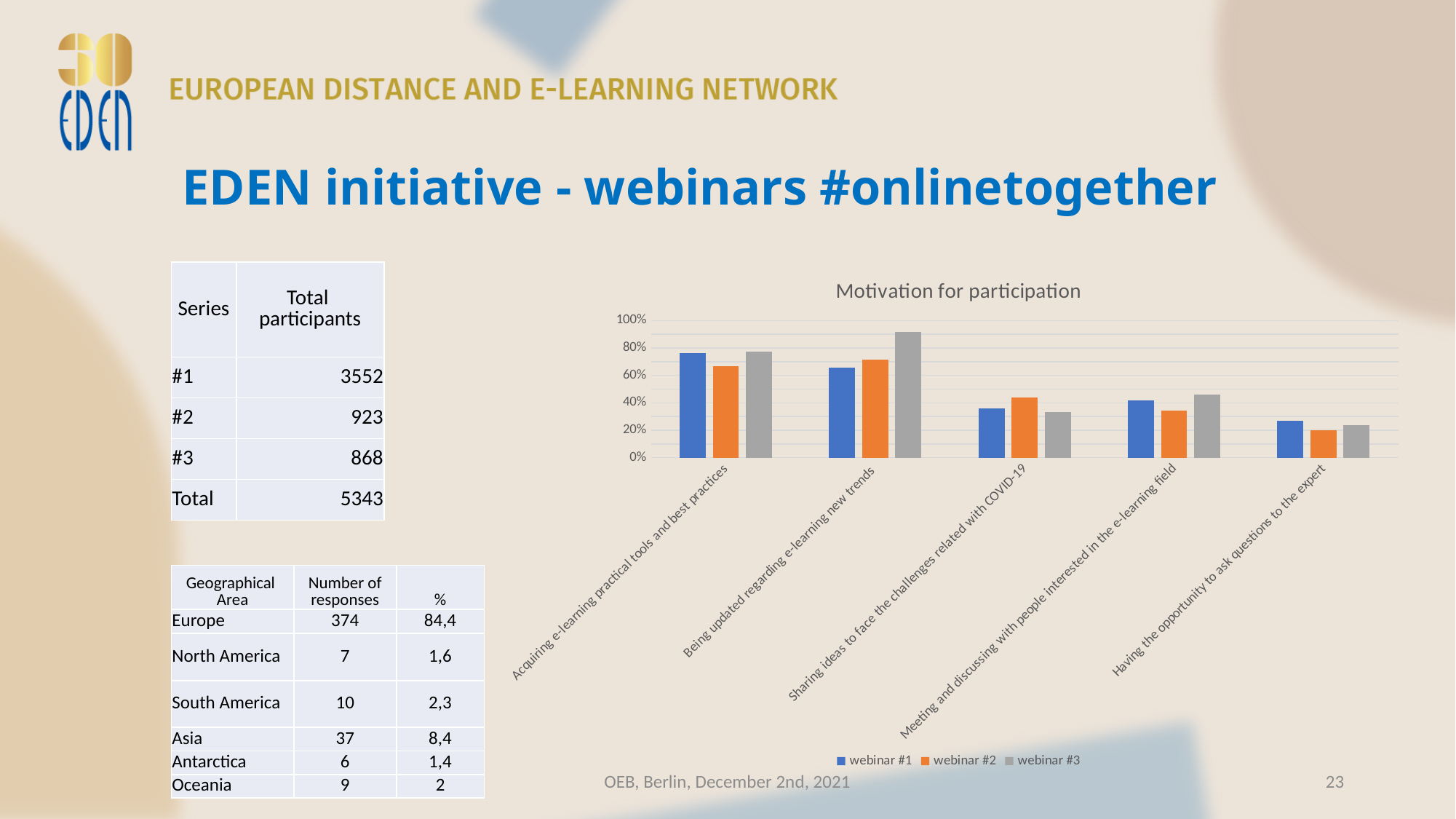
For 'Being updated regarding e-learning new trends', which is larger: webinar #1 or webinar #3? webinar #3 What is the title of the chart? Motivation for participation Which category has the tallest bar in the chart? Being updated regarding e-learning new trends Is the webinar #2 value for 'Having the opportunity to ask questions to the expert' greater or less than 40%? less Which category has the lowest values across all three webinars? Having the opportunity to ask questions to the expert Is the webinar #3 value for 'Being updated regarding e-learning new trends' greater or less than 80%? greater Which series is shown in orange in the chart? webinar #2 How many motivation categories are shown on the x axis of the chart? 5 For 'Sharing ideas to face the challenges related with COVID-19', which is larger: webinar #2 or webinar #3? webinar #2 Is the webinar #1 value for 'Acquiring e-learning practical tools and best practices' greater or less than 60%? greater How many series does the chart legend list? 3 What kind of chart is shown on the slide? bar chart